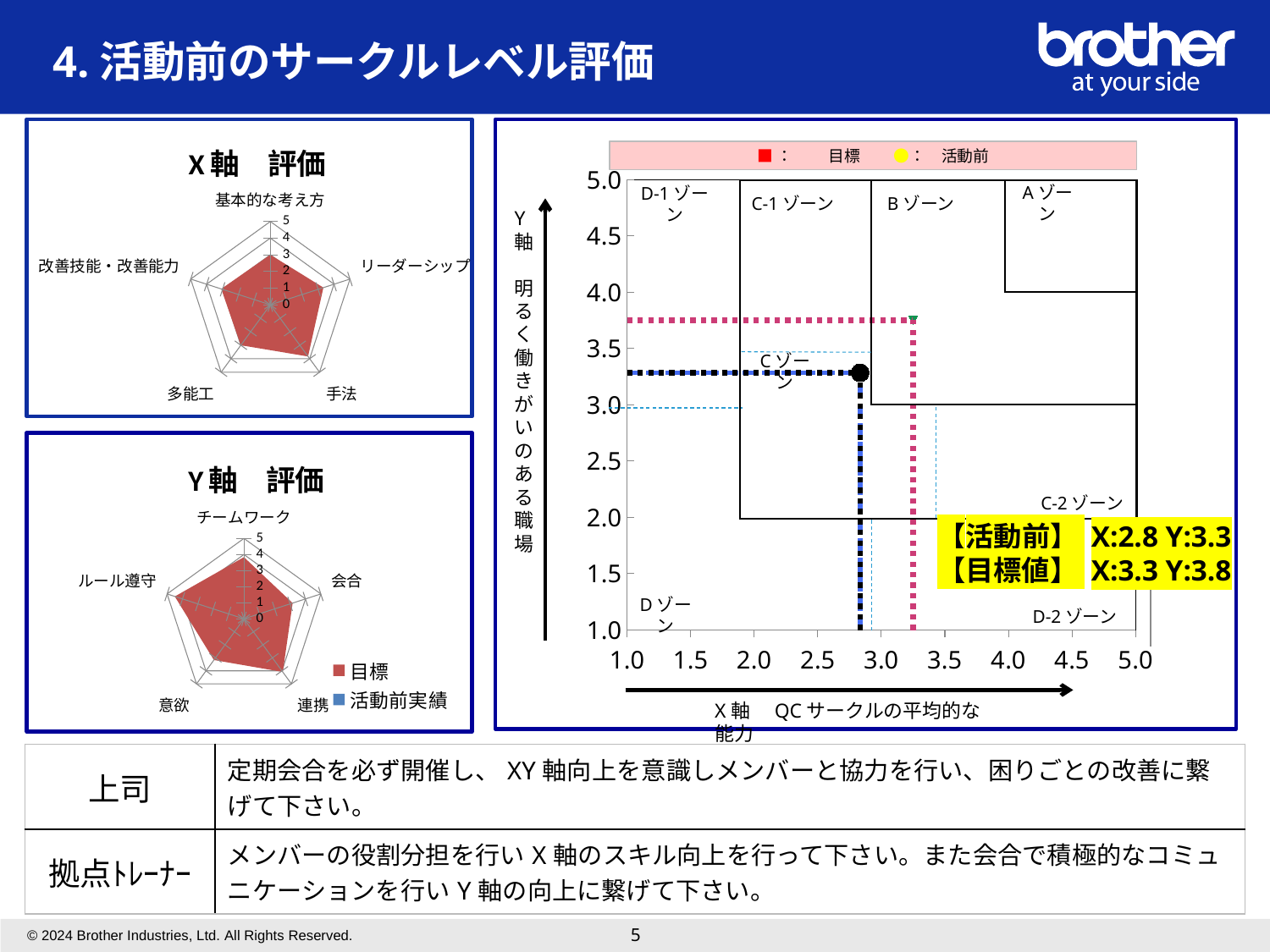
In the zone chart on the right, what is the difference between the Y value of 目標値 and the Y value of 活動前? 0.5 How many categories does the Y軸 評価 radar chart have? 5 How many series does the legend of the Y軸 評価 chart list? 2 In the zone chart on the right, what is the difference between the X value of 目標値 and the X value of 活動前? 0.5 What are the two legend entries of the zone chart on the right? 目標, 活動前 How many categories does the X軸 評価 radar chart have? 5 In the zone chart on the right, what is the X value for 活動前? 2.8 In the zone chart on the right, what is the Y value for 目標値? 3.8 In the zone chart on the right, which has the larger Y value, 活動前 or 目標値? 目標値 In the zone chart on the right, is the Y value for 活動前 greater or less than 3.0? greater What is the title of the top-left radar chart? X軸 評価 What kind of chart is the X軸 評価 chart? radar chart